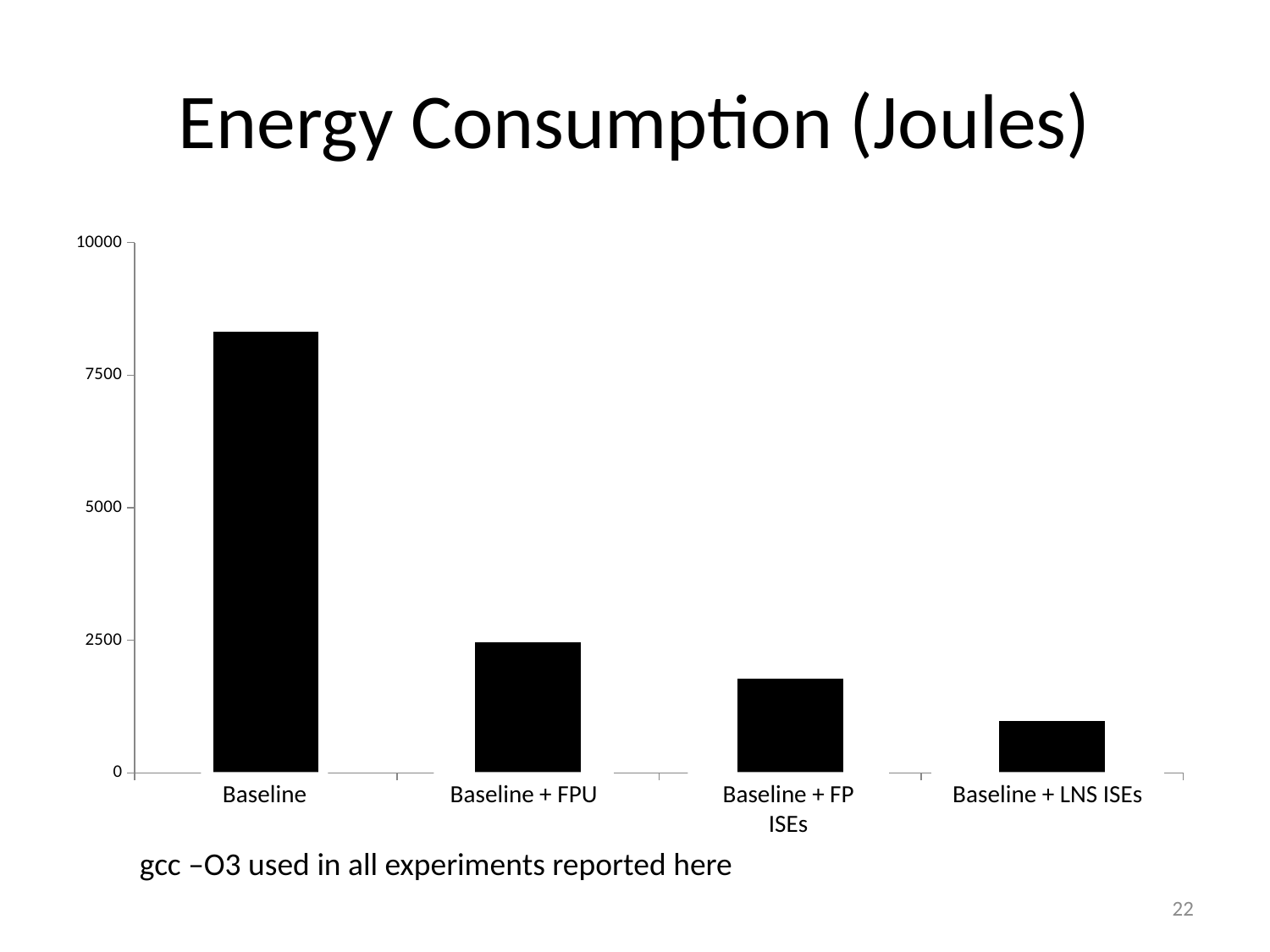
Is the value for Baseline + LNS ISEs greater or less than 2500? less How many categories are plotted on the x axis? 4 Is the value for Baseline greater or less than 7500? greater Which is larger, the value for Baseline + FPU or the value for Baseline + LNS ISEs? Baseline + FPU What is the highest tick value shown on the y axis? 10000 Is the value for Baseline + FP ISEs greater or less than 2500? less What is the title of the chart? Energy Consumption (Joules) What kind of chart is shown on the slide? bar chart Which category has the highest energy consumption? Baseline Do the values rise or fall moving from left to right along the x axis? fall Which category has the lowest energy consumption? Baseline + LNS ISEs